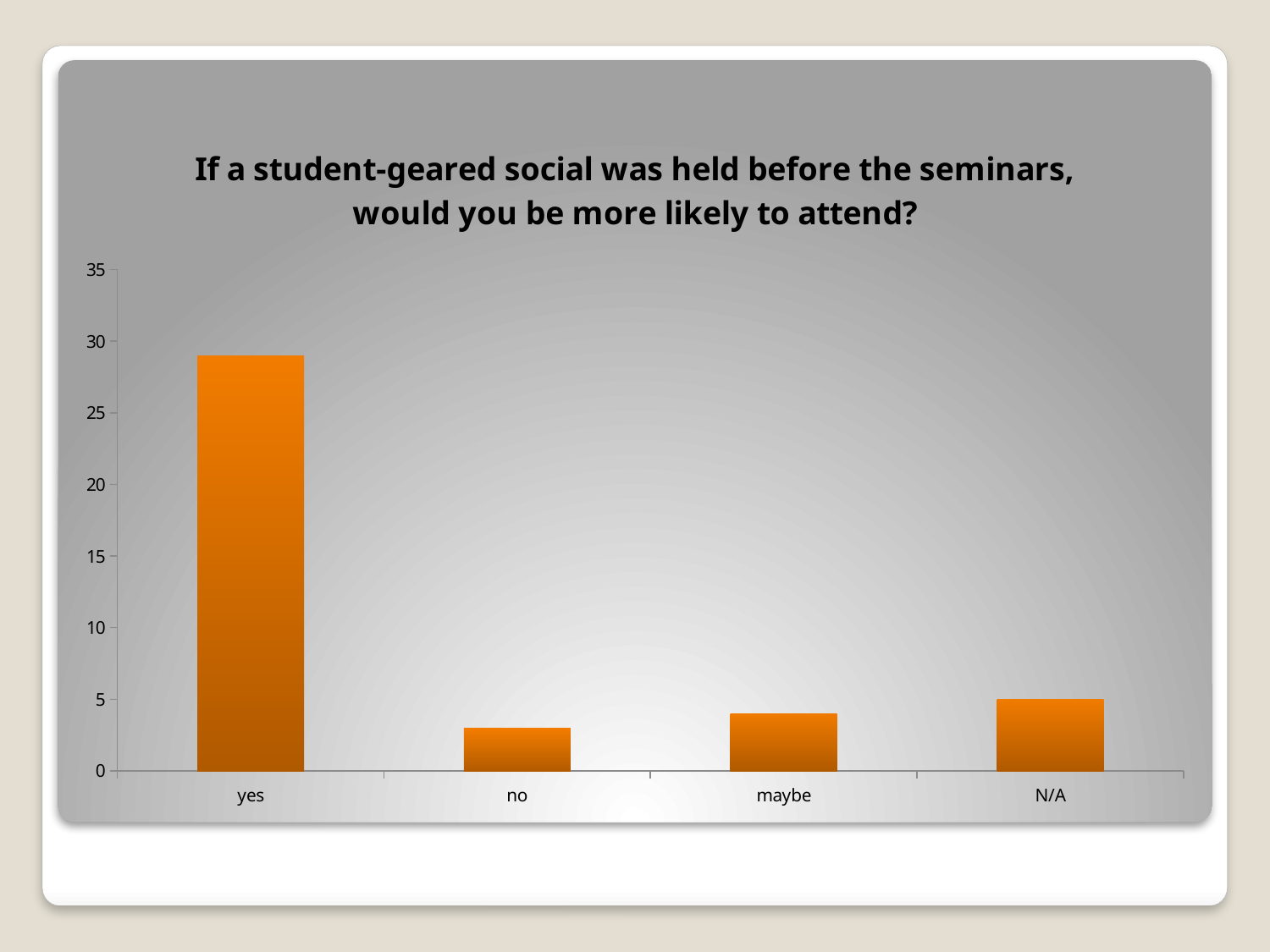
Is the value for "yes" greater or less than 30? less Is the value for "yes" greater or less than 25? greater Which response category has the highest bar? yes What is the highest value shown on the y axis? 35 Which is larger, the value for "yes" or the value for "N/A"? yes What is the value for "N/A"? 5 Is the value for "maybe" greater or less than 5? less What is the title of the chart? If a student-geared social was held before the seminars, would you be more likely to attend? What kind of chart is shown on the slide? bar chart Which is larger, the value for "no" or the value for "yes"? yes How many response categories are shown on the x axis? 4